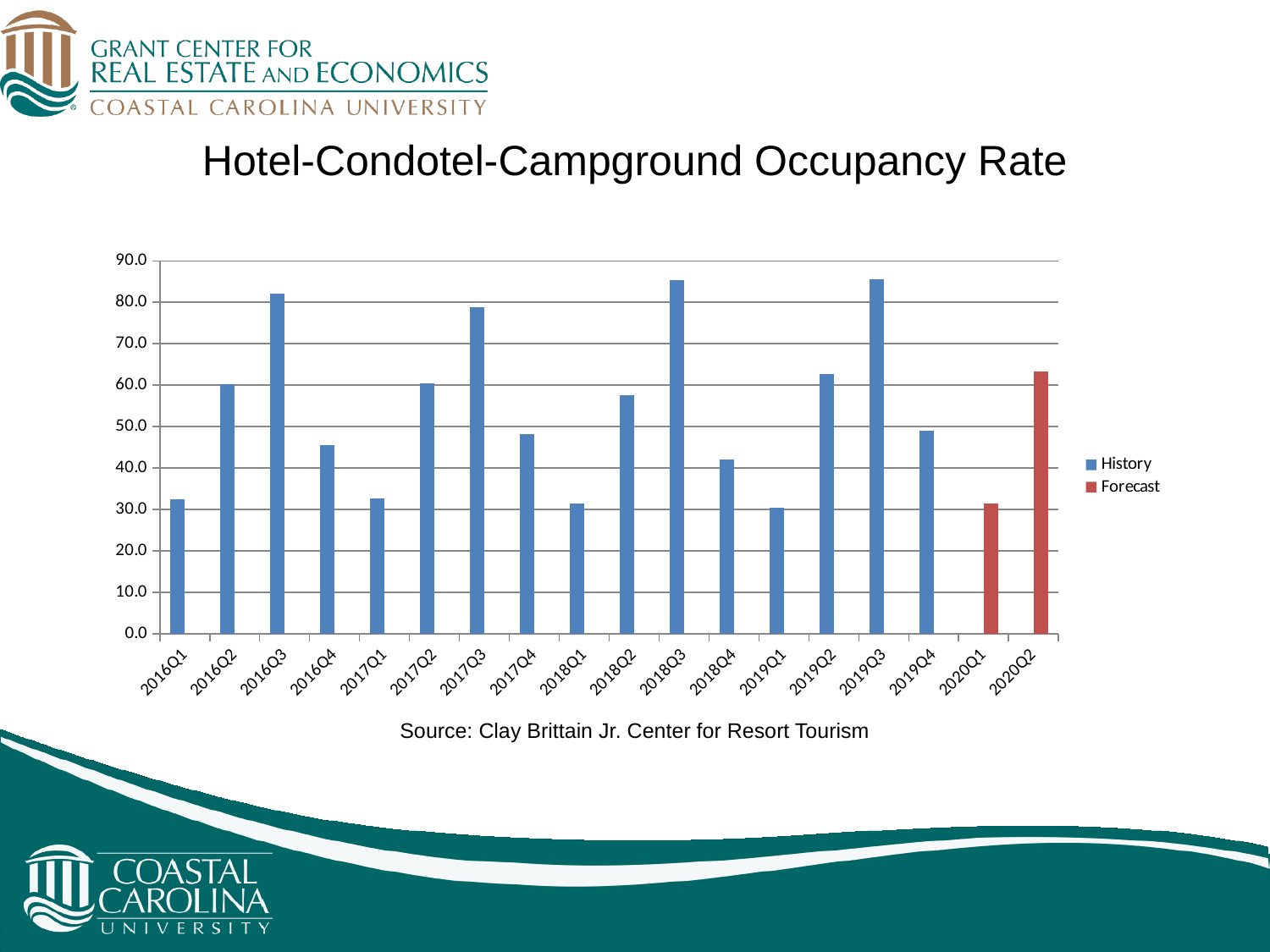
Which is larger, the value for 2016Q3 or the value for 2017Q3? 2016Q3 Is the value for 2018Q4 greater or less than 40.0? greater Which quarters are shown as Forecast rather than History? 2020Q1 and 2020Q2 What is the title of the chart? Hotel-Condotel-Campground Occupancy Rate Is the value for 2016Q4 greater or less than 50.0? less What kind of chart is shown on the slide? Bar chart Which is larger, the value for 2019Q2 or the value for 2018Q2? 2019Q2 Is the value for 2017Q3 greater or less than 80.0? less How many quarters are plotted along the x axis? 18 How many series does the legend list? 2